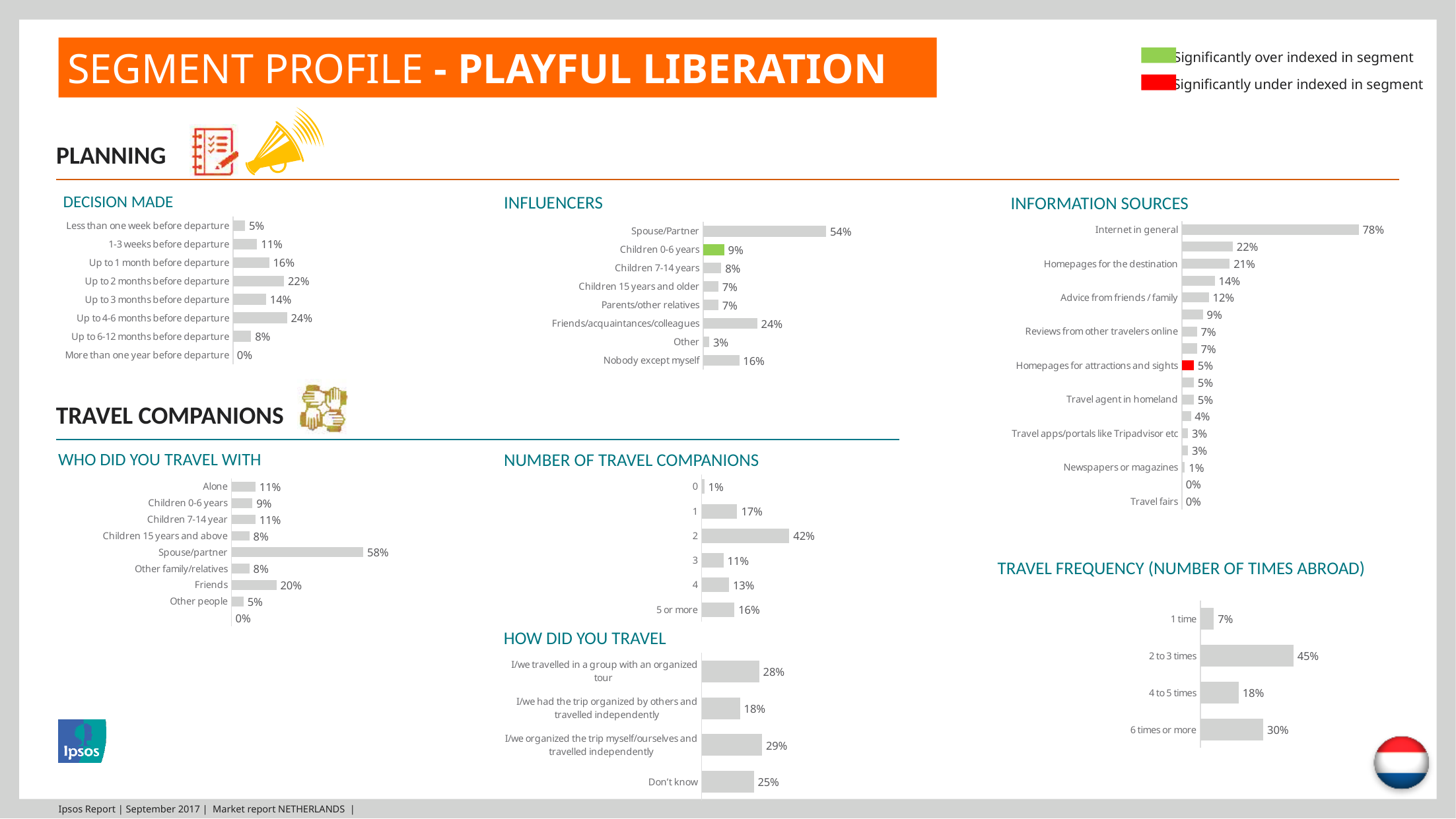
In the INFLUENCERS chart, which category has the highest value? Spouse/Partner In the NUMBER OF TRAVEL COMPANIONS chart, which category has the lowest value? 0 What type of chart is the TRAVEL FREQUENCY (NUMBER OF TIMES ABROAD) chart? Bar chart In the WHO DID YOU TRAVEL WITH chart, what is the value for 'Spouse/partner'? 58% In the WHO DID YOU TRAVEL WITH chart, which of 'Friends' or 'Alone' has the larger value? Friends In the INFORMATION SOURCES chart, which category is shown with a red bar? Homepages for attractions and sights In the INFLUENCERS chart, which bar is coloured green? Children 0-6 years In the HOW DID YOU TRAVEL chart, what is the value for 'Don't know'? 25% In the DECISION MADE chart, what is the value for 'Up to 4-6 months before departure'? 24% In the INFLUENCERS chart, what is the difference between 'Friends/acquaintances/colleagues' and 'Nobody except myself'? 8% In the INFORMATION SOURCES chart, what is the value for 'Internet in general'? 78% In the DECISION MADE chart, how many categories are shown? 8